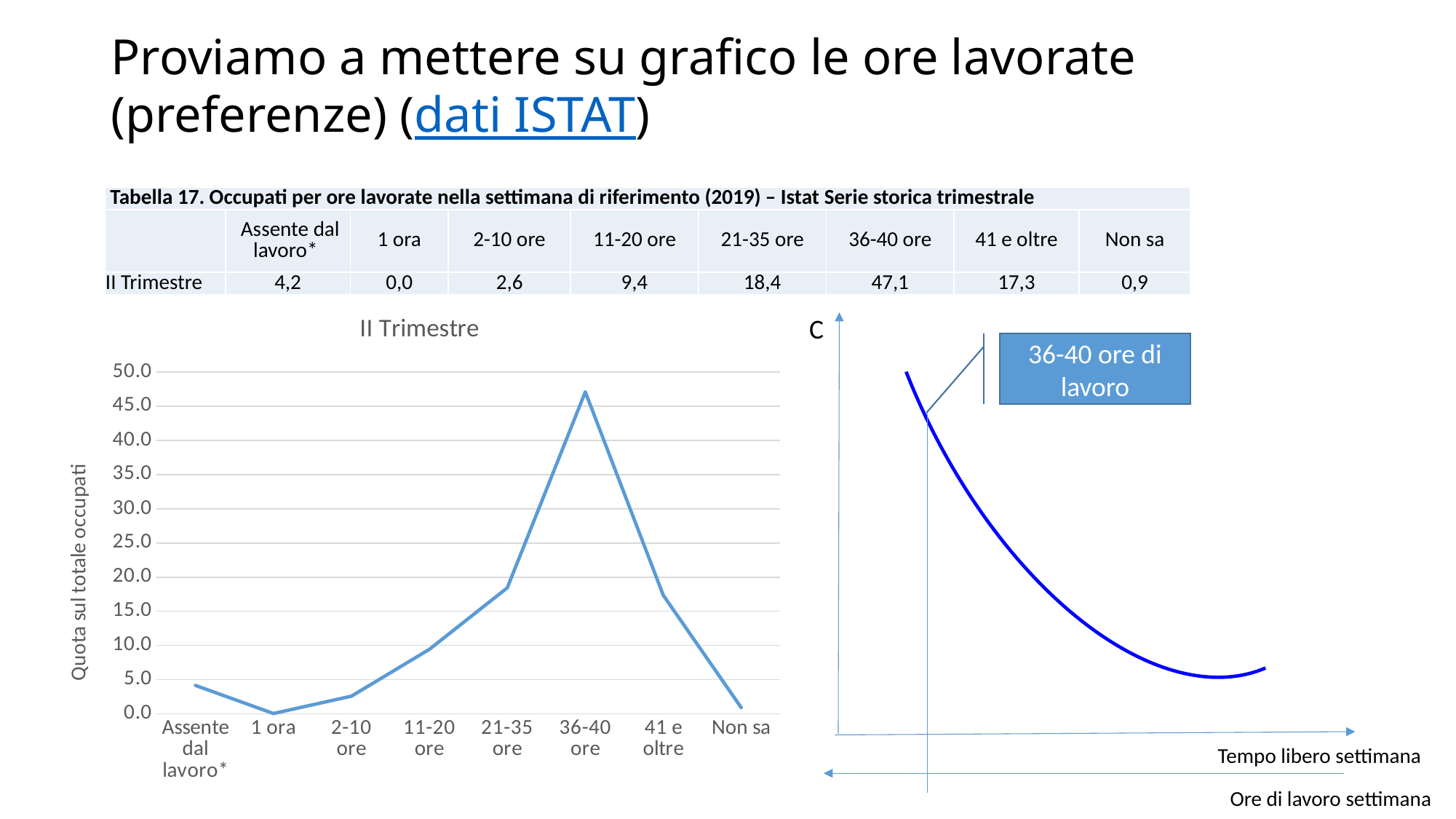
In the 'II Trimestre' chart, is the value for '36-40 ore' greater or less than 45.0? greater In the 'II Trimestre' chart, how many categories are shown on the x axis? 8 In the 'II Trimestre' chart, which category has the lowest value? 1 ora In the 'II Trimestre' chart, is the value for '11-20 ore' greater or less than 10.0? less Using the table values, what is the difference between '36-40 ore' (47,1) and '41 e oltre' (17,3) in II Trimestre? 29,8 According to the table on the slide, what is the value for '21-35 ore' in II Trimestre? 18,4 In the 'II Trimestre' chart, what kind of chart is used to plot the data? line chart In the 'II Trimestre' chart, which is larger: the value for '21-35 ore' or the value for '41 e oltre'? 21-35 ore According to the table on the slide, what is the value for 'Non sa' in II Trimestre? 0,9 According to the table on the slide, what is the value for '36-40 ore' in II Trimestre? 47,1 What is the label of the y axis in the 'II Trimestre' chart? Quota sul totale occupati In the 'II Trimestre' chart, which category has the highest value? 36-40 ore